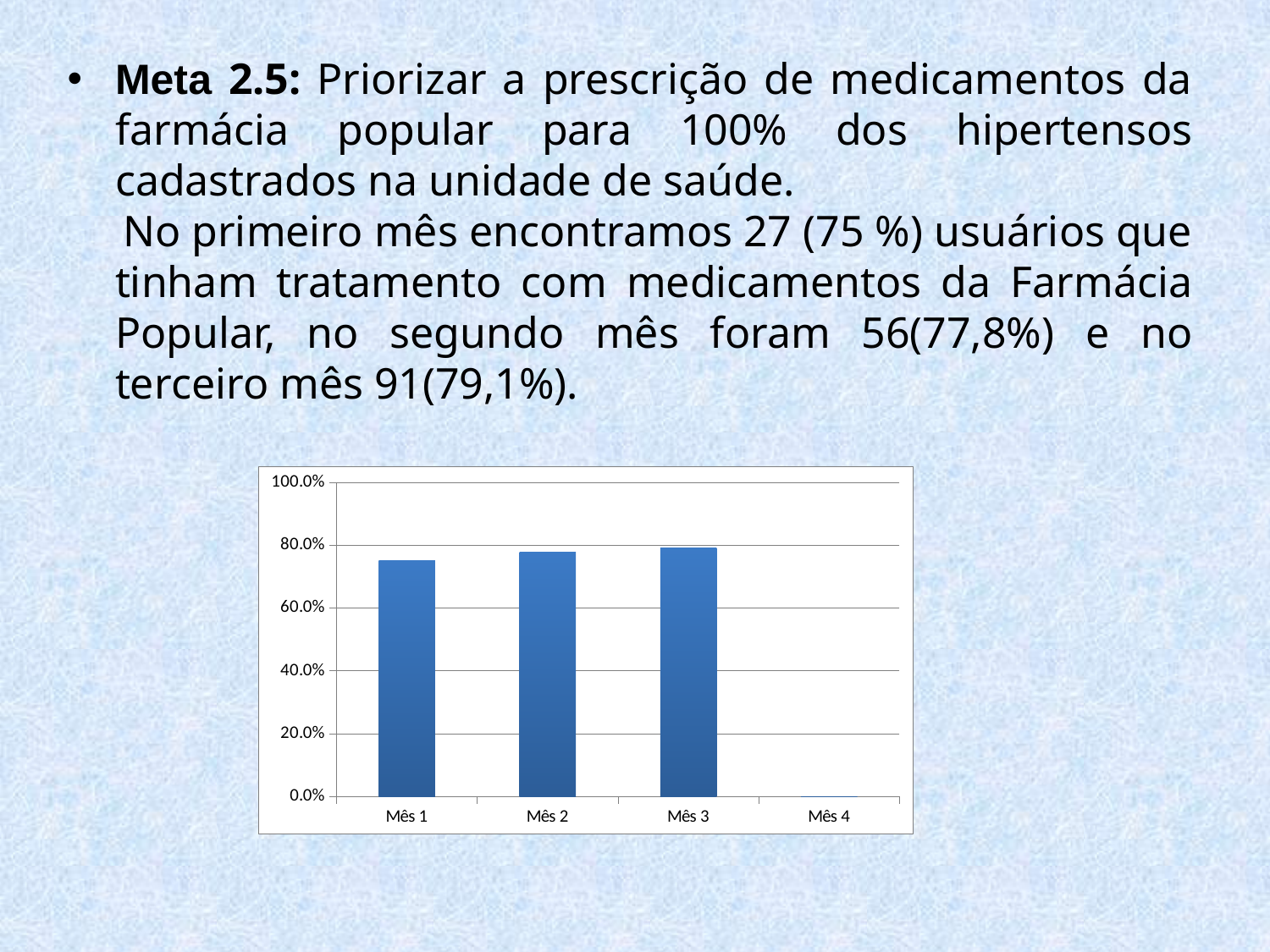
Which category on the chart has no visible bar? Mês 4 What is the highest tick label on the y axis of the chart? 100.0% Which category on the chart has the tallest bar? Mês 3 Is the value for Mês 1 greater or less than 60.0%? greater Is the value for Mês 2 greater or less than 60.0%? greater Which is larger, the value for Mês 1 or the value for Mês 3? Mês 3 Do the bar values rise or fall from Mês 1 to Mês 3? rise How many categories are shown on the x axis of the chart? 4 What kind of chart is shown on the slide? bar chart Is the value for Mês 1 greater or less than 80.0%? less